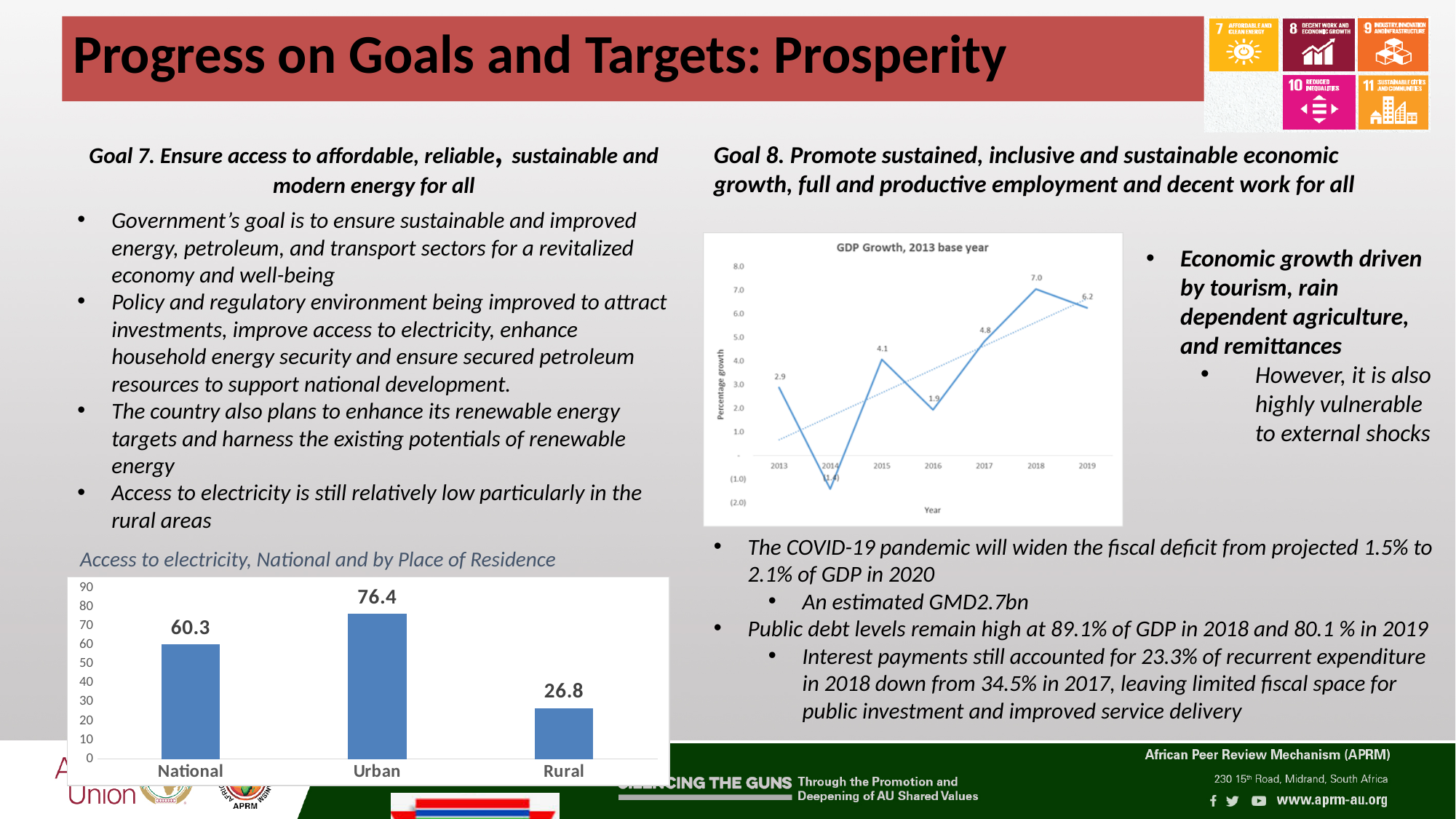
In the 'Access to electricity, National and by Place of Residence' chart, which category has the highest value? Urban In the 'Access to electricity, National and by Place of Residence' chart, which category has the lowest value? Rural In the 'GDP Growth, 2013 base year' chart, what is the value for 2018? 7.0 What kind of chart is 'GDP Growth, 2013 base year'? Line chart In the 'Access to electricity, National and by Place of Residence' chart, what is the value for Rural? 26.8 What kind of chart is 'Access to electricity, National and by Place of Residence'? Bar chart In the 'Access to electricity, National and by Place of Residence' chart, how many categories are shown? 3 In the 'Access to electricity, National and by Place of Residence' chart, what is the difference between the Urban and Rural values? 49.6 In the 'Access to electricity, National and by Place of Residence' chart, what is the value for Urban? 76.4 In the 'GDP Growth, 2013 base year' chart, is the value for 2017 larger than the value for 2015? Yes In the 'GDP Growth, 2013 base year' chart, what is the value for 2016? 1.9 In the 'GDP Growth, 2013 base year' chart, which year has the highest value? 2018